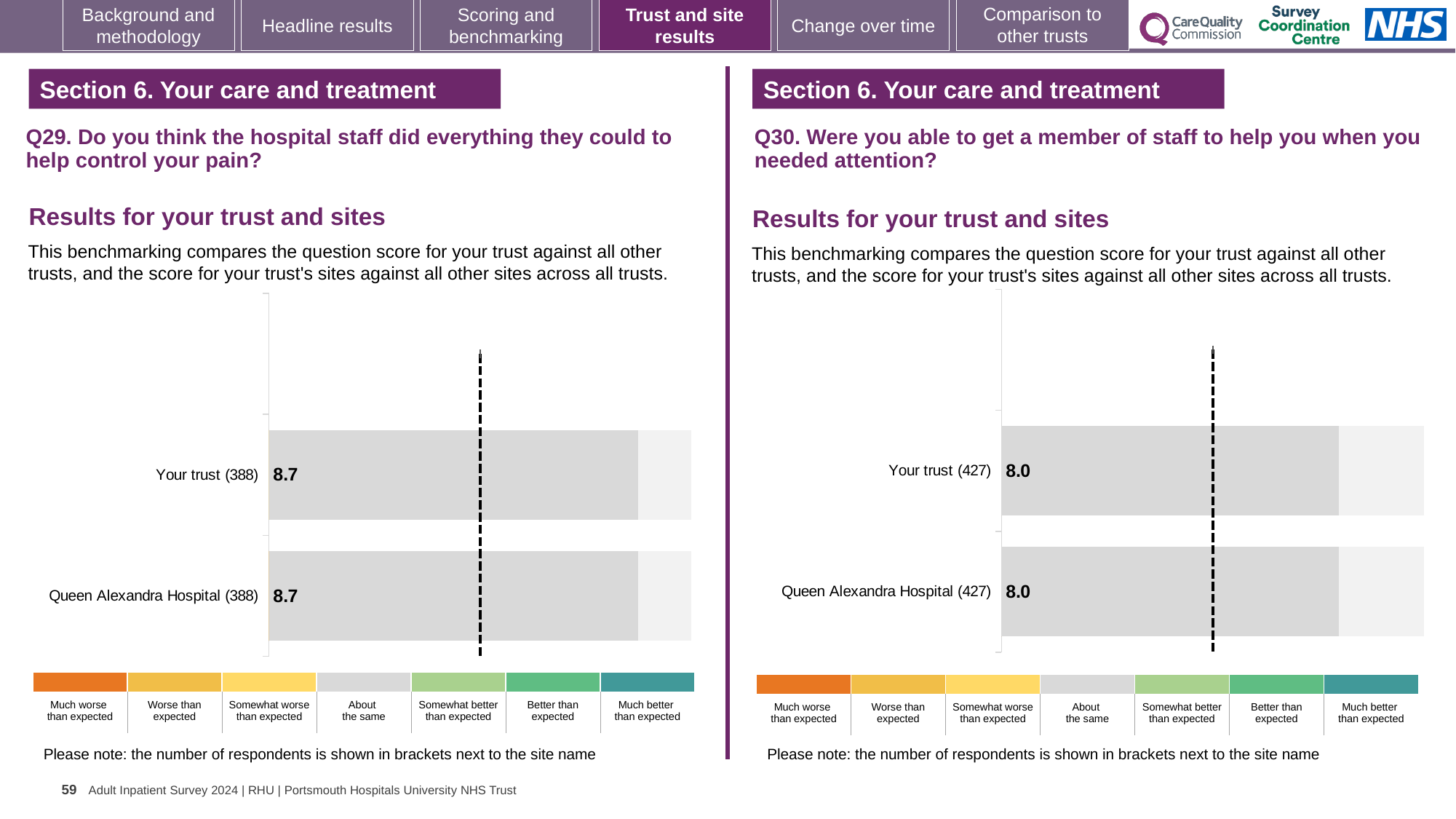
What kind of chart is used on the Q29 chart (left)? Bar chart On the Q30 chart (right), what is the score for Your trust? 8.0 On the Q29 chart (left), what is the score for Your trust? 8.7 On the Q29 chart (left), how many respondents are shown in brackets next to Your trust? 388 On the Q29 chart (left), what is the difference between the score for Your trust and the score for Queen Alexandra Hospital? 0.0 On the Q30 chart (right), what is the difference between the score for Your trust and the score for Queen Alexandra Hospital? 0.0 How many bars are plotted on the Q30 chart (right)? 2 On the Q30 chart (right), what is the score for Queen Alexandra Hospital? 8.0 How many bars are plotted on the Q29 chart (left)? 2 On the Q29 chart (left), what is the score for Queen Alexandra Hospital? 8.7 Is the score for Your trust on the Q29 chart (left) larger or smaller than the score for Your trust on the Q30 chart (right)? Larger On the Q30 chart (right), how many respondents are shown in brackets next to Queen Alexandra Hospital? 427